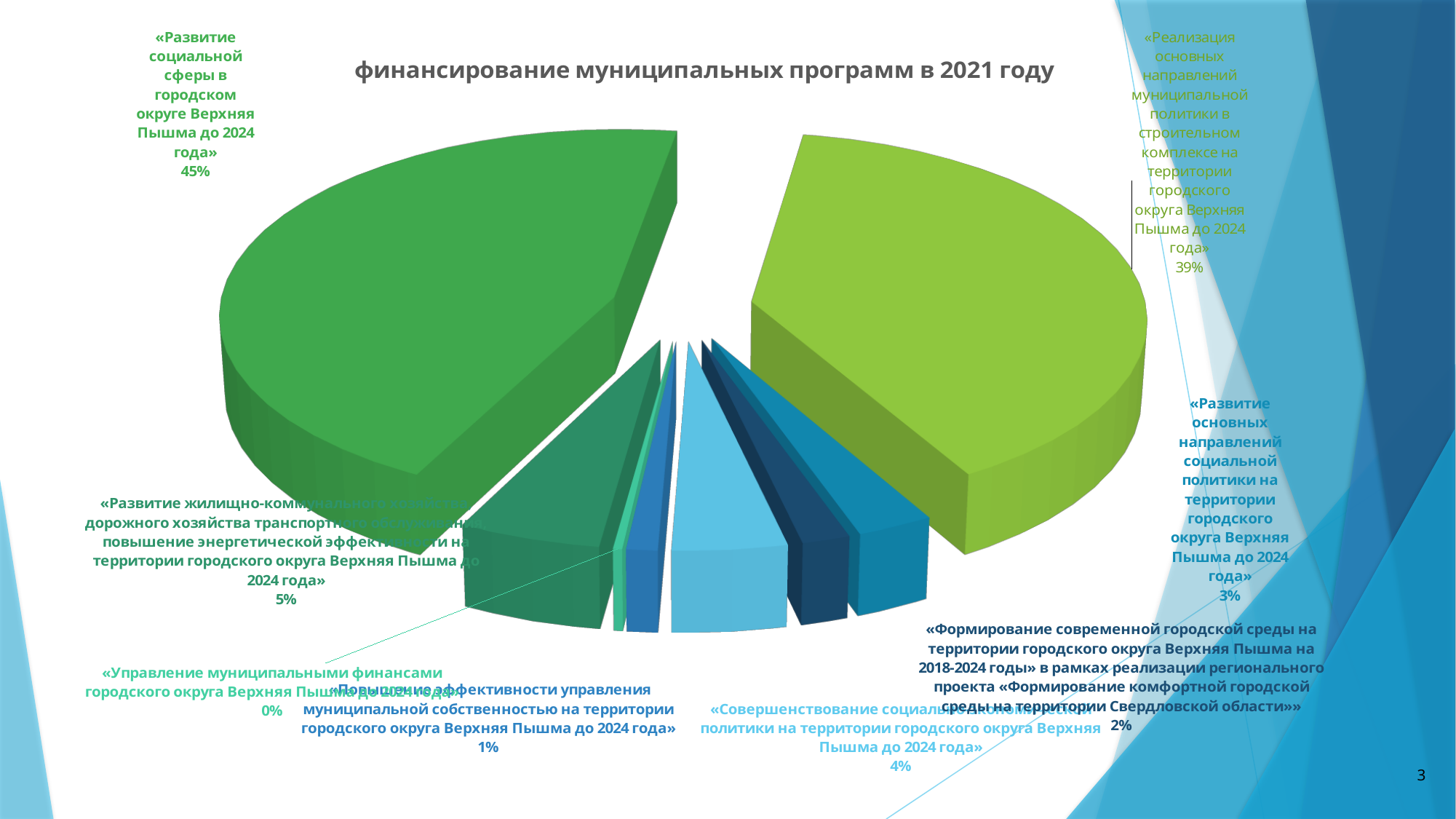
What percentage is labelled for the program «Совершенствование социально-экономической политики на территории городского округа Верхняя Пышма до 2024 года»? 4% What is the title of the chart? финансирование муниципальных программ в 2021 году Which has a larger share: «Развитие жилищно-коммунального хозяйства...» or «Формирование современной городской среды...»? «Развитие жилищно-коммунального хозяйства...» What share of financing goes to the program «Развитие социальной сферы в городском округе Верхняя Пышма до 2024 года»? 45% What share is shown for «Развитие основных направлений социальной политики на территории городского округа Верхняя Пышма до 2024 года»? 3% How many slices (programs) are shown in the pie chart? 8 What is the difference in percentage points between the share for «Развитие социальной сферы...» (45%) and the share for «Реализация основных направлений муниципальной политики в строительном комплексе...» (39%)? 6 percentage points What percentage is labelled for «Управление муниципальными финансами городского округа Верхняя Пышма до 2024 года»? 0% Which program has the smallest share of financing in the pie chart? «Управление муниципальными финансами городского округа Верхняя Пышма до 2024 года» Which program has the largest share of financing in the pie chart? «Развитие социальной сферы в городском округе Верхняя Пышма до 2024 года» What type of chart is shown on the slide? pie chart What share is shown for the program «Реализация основных направлений муниципальной политики в строительном комплексе на территории городского округа Верхняя Пышма до 2024 года»? 39%